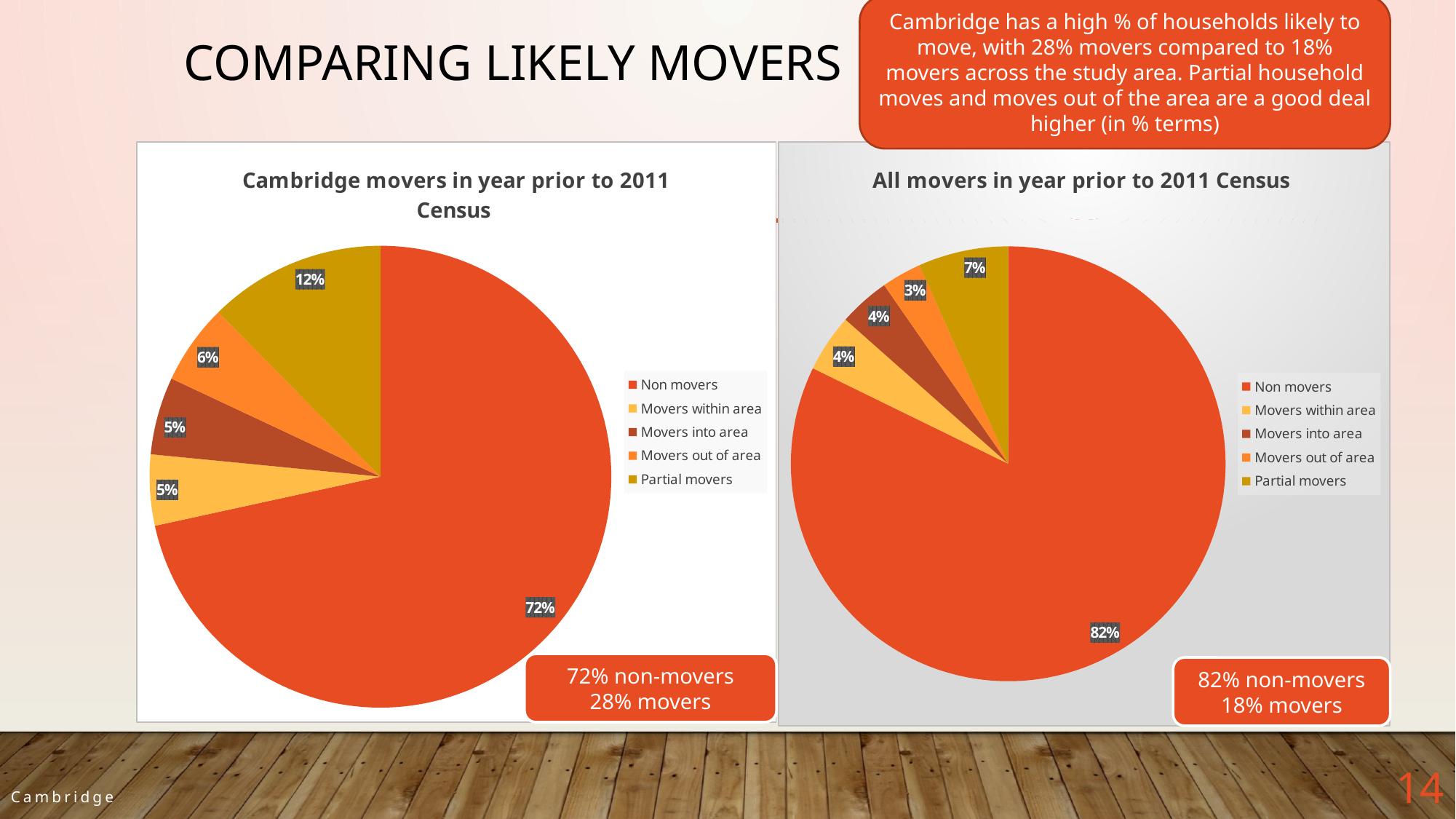
In the 'Cambridge movers in year prior to 2011 Census' chart, what percentage is shown for Partial movers? 12% In the 'Cambridge movers in year prior to 2011 Census' chart, what percentage is shown for Non movers? 72% In the 'All movers in year prior to 2011 Census' chart, what percentage is shown for Movers out of area? 3% What type of chart is the 'All movers in year prior to 2011 Census' chart? Pie chart In the 'Cambridge movers in year prior to 2011 Census' chart, what percentage is shown for Movers out of area? 6% In the 'All movers in year prior to 2011 Census' chart, what percentage is shown for Non movers? 82% What is the difference between the Non movers percentage in the 'All movers in year prior to 2011 Census' chart and the Non movers percentage in the 'Cambridge movers in year prior to 2011 Census' chart? 10% In the 'All movers in year prior to 2011 Census' chart, which category has the smallest slice? Movers out of area How many categories does the legend of the 'Cambridge movers in year prior to 2011 Census' chart list? 5 Is the Partial movers slice larger in the 'Cambridge movers in year prior to 2011 Census' chart or in the 'All movers in year prior to 2011 Census' chart? Cambridge movers in year prior to 2011 Census In the 'All movers in year prior to 2011 Census' chart, what percentage is shown for Partial movers? 7% In the 'Cambridge movers in year prior to 2011 Census' chart, which category has the largest slice? Non movers